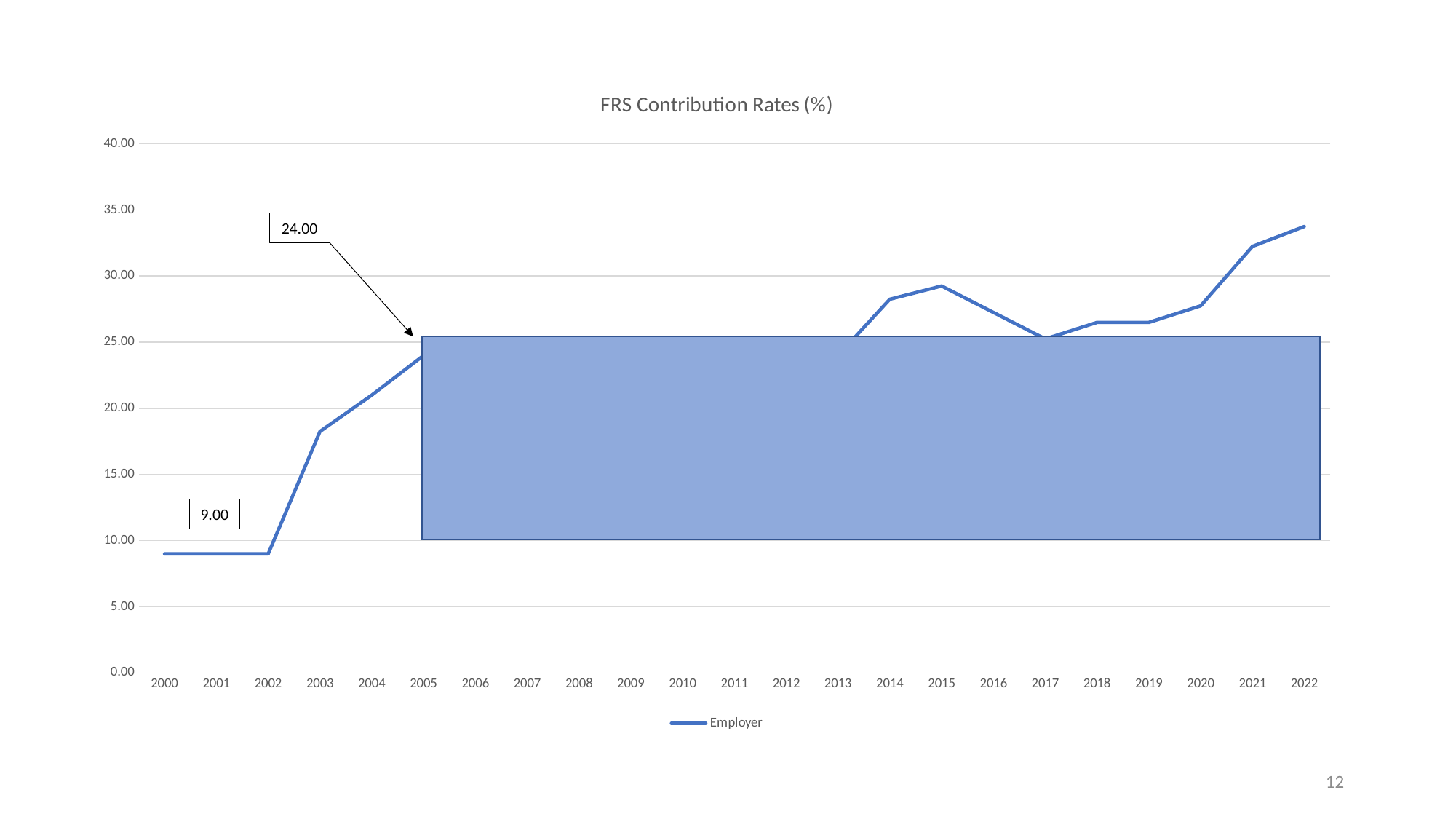
What is the name of the series shown in the legend? Employer Which year has the larger Employer value, 2015 or 2017? 2015 Which year has the highest Employer contribution rate? 2022 Is the Employer value for 2003 greater or less than 20.00? less How many series does the legend list? 1 What type of chart is shown on the slide? Line chart What is the Employer contribution rate labelled for 2005? 24.00 What is the Employer contribution rate labelled for 2000? 9.00 What is the difference between the labelled values for 2005 and 2000? 15.00 What is the title of the chart? FRS Contribution Rates (%) How many years are shown on the x axis? 23 Is the Employer value for 2022 greater or less than 30.00? greater